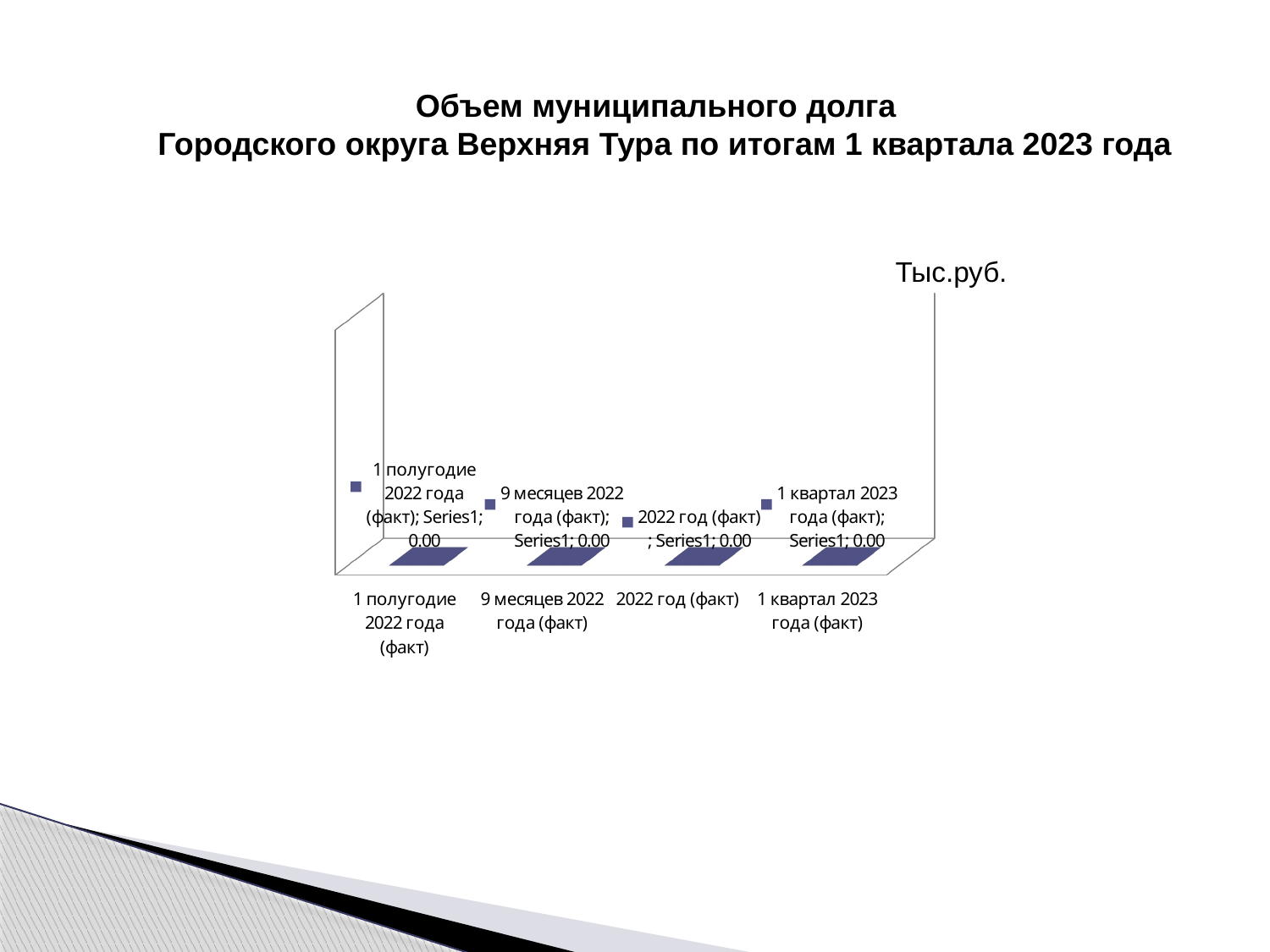
What kind of chart is shown on the slide? bar chart What is the difference between the values for 2022 год (факт) and 1 квартал 2023 года (факт)? 0.00 What is the name of the series shown in the data labels? Series1 What unit of measurement is shown next to the chart? Тыс.руб. What is the value for 9 месяцев 2022 года (факт)? 0.00 What is the value for 2022 год (факт)? 0.00 How many categories are shown on the x axis of the chart? 4 What is the value for 1 полугодие 2022 года (факт)? 0.00 What is the value for 1 квартал 2023 года (факт)? 0.00 Do the values rise, fall or stay the same across the categories from left to right? stay the same